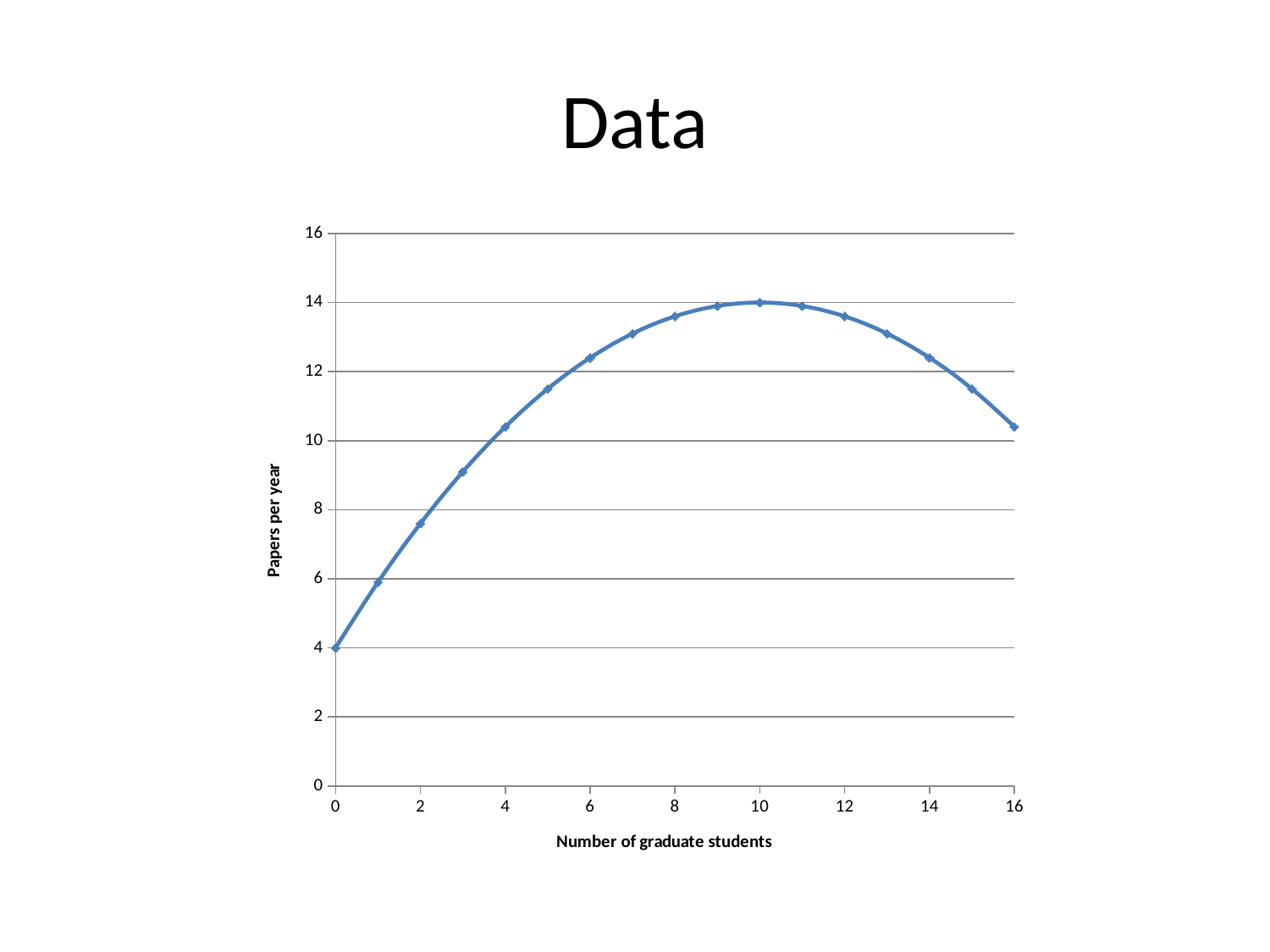
What kind of chart is shown on the slide? line chart How do papers per year change as the number of graduate students increases from 0 to 16? rise to a peak at 10, then fall What is the value of papers per year when the number of graduate students is 10? 14 What is the value of papers per year when the number of graduate students is 0? 4 What is the label of the x axis? Number of graduate students At which number of graduate students is papers per year lowest? 0 Which has more papers per year: 2 graduate students or 14 graduate students? 14 graduate students Is the value for 16 graduate students greater or less than 12? less Is the value for 2 graduate students greater or less than 8? less Is the value for 6 graduate students greater or less than 12? greater At which number of graduate students is papers per year highest? 10 How many data points are plotted on the chart? 17